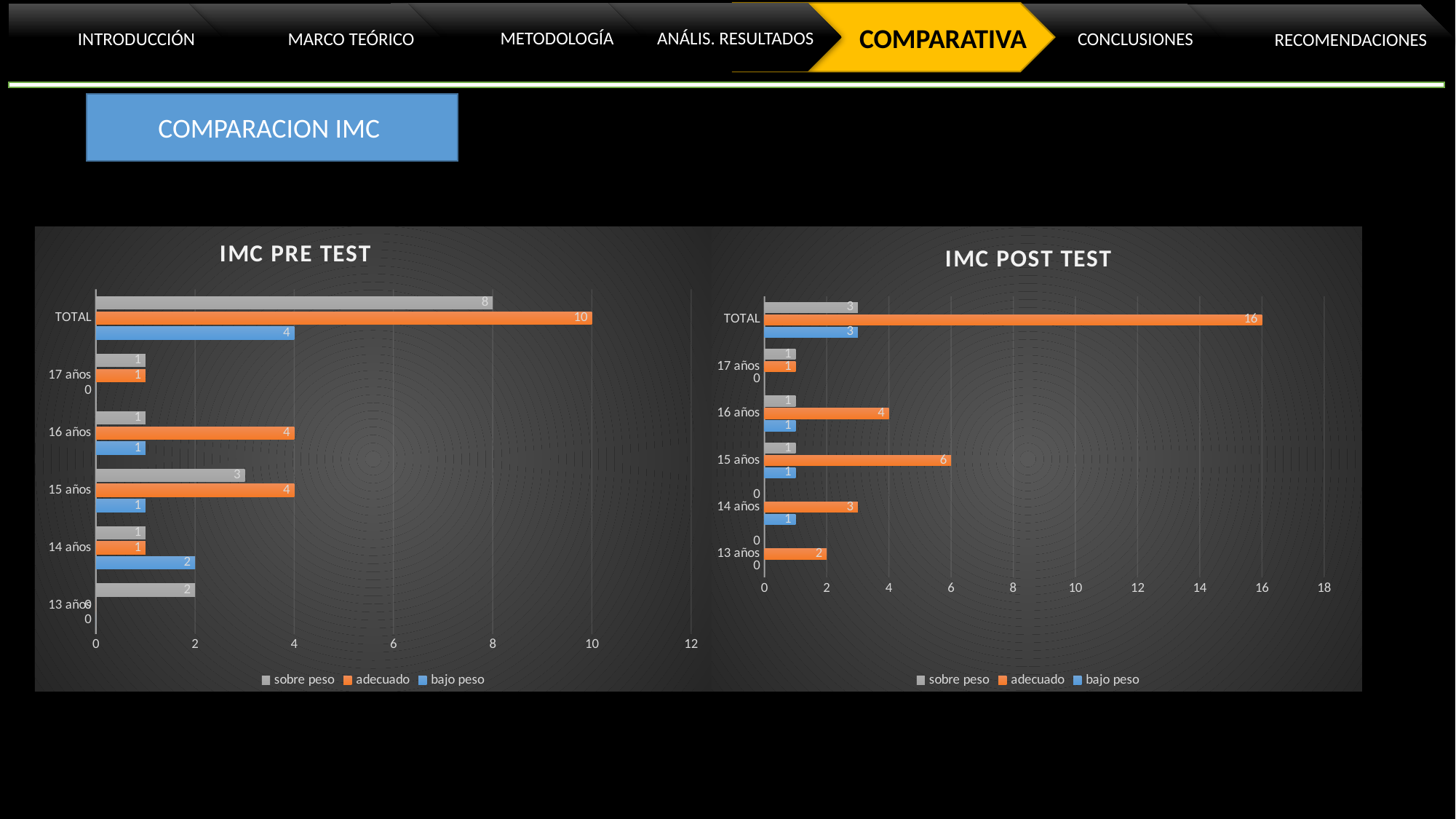
In the IMC PRE TEST chart, what is the adecuado value for TOTAL? 10 Is the TOTAL adecuado value larger in the IMC PRE TEST chart or the IMC POST TEST chart? IMC POST TEST In the IMC POST TEST chart, what is the adecuado value for TOTAL? 16 In the IMC PRE TEST chart, what is the bajo peso value for 14 años? 2 In the IMC POST TEST chart, is the TOTAL adecuado value greater or less than 14? greater In the IMC PRE TEST chart, what is the difference between the adecuado and bajo peso values for TOTAL? 6 How many series does the legend of the IMC PRE TEST chart list? 3 In the IMC PRE TEST chart, what is the sobre peso value for 15 años? 3 In the IMC PRE TEST chart, what is the sobre peso value for 13 años? 2 In the IMC POST TEST chart, which age group has the highest adecuado value (excluding TOTAL)? 15 años What kind of chart is the IMC POST TEST chart? bar chart In the IMC POST TEST chart, what is the adecuado value for 15 años? 6